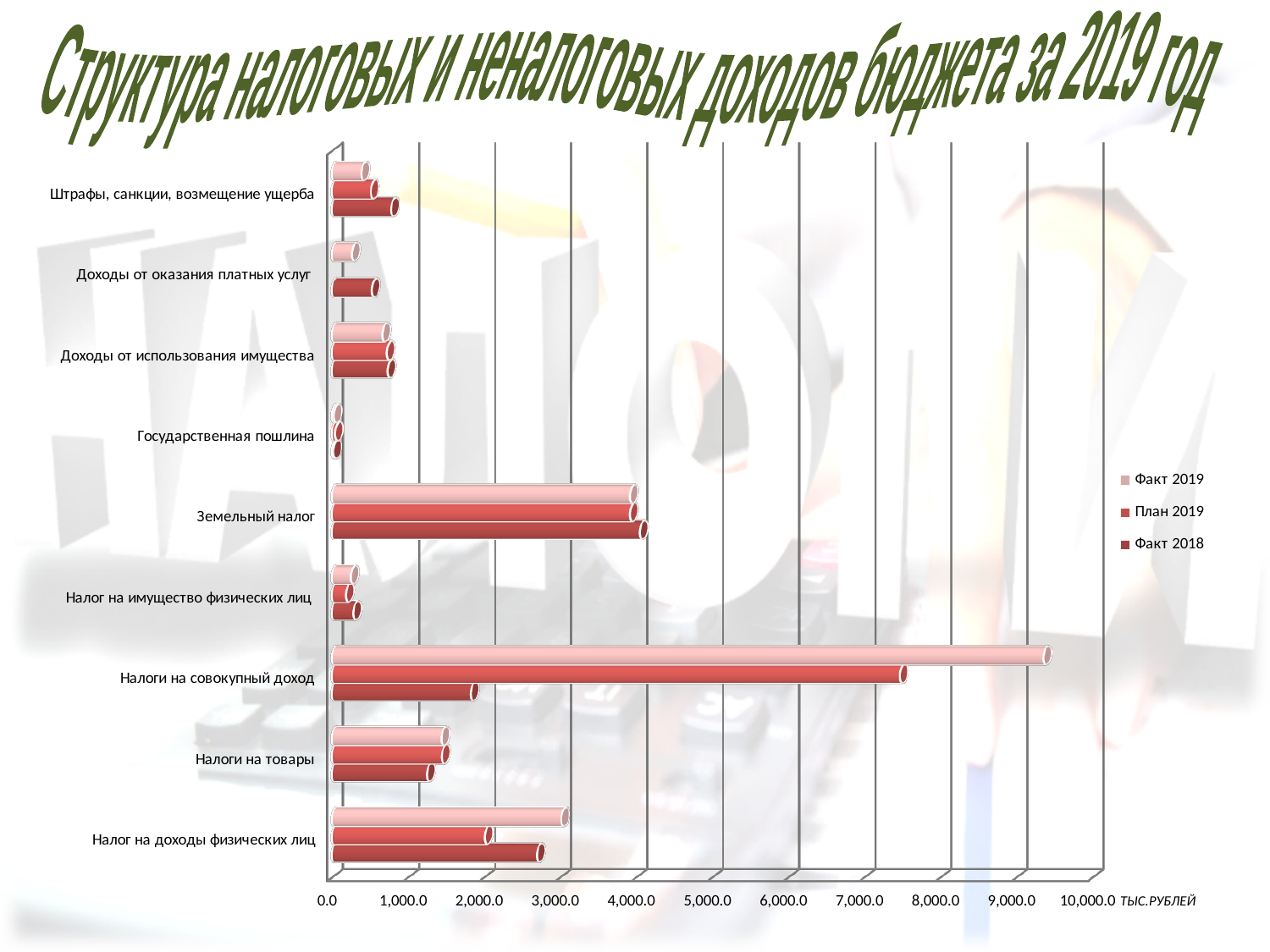
For Налоги на совокупный доход, which is larger: the Факт 2019 value or the Факт 2018 value? Факт 2019 Which category has the highest value for Факт 2019? Налоги на совокупный доход How many series does the legend list? 3 What kind of chart is shown on the slide? bar chart Is the План 2019 value for Налоги на совокупный доход greater or less than 7,000.0? greater For Факт 2019, which is larger: Земельный налог or Налоги на товары? Земельный налог What is the title of the chart? Структура налоговых и неналоговых доходов бюджета за 2019 год Is the Факт 2019 value for Налоги на совокупный доход greater or less than 8,000.0? greater How many categories are plotted on the chart? 9 Which category has the lowest value for Факт 2019? Государственная пошлина Is the Факт 2019 value for Земельный налог greater or less than 3,000.0? greater